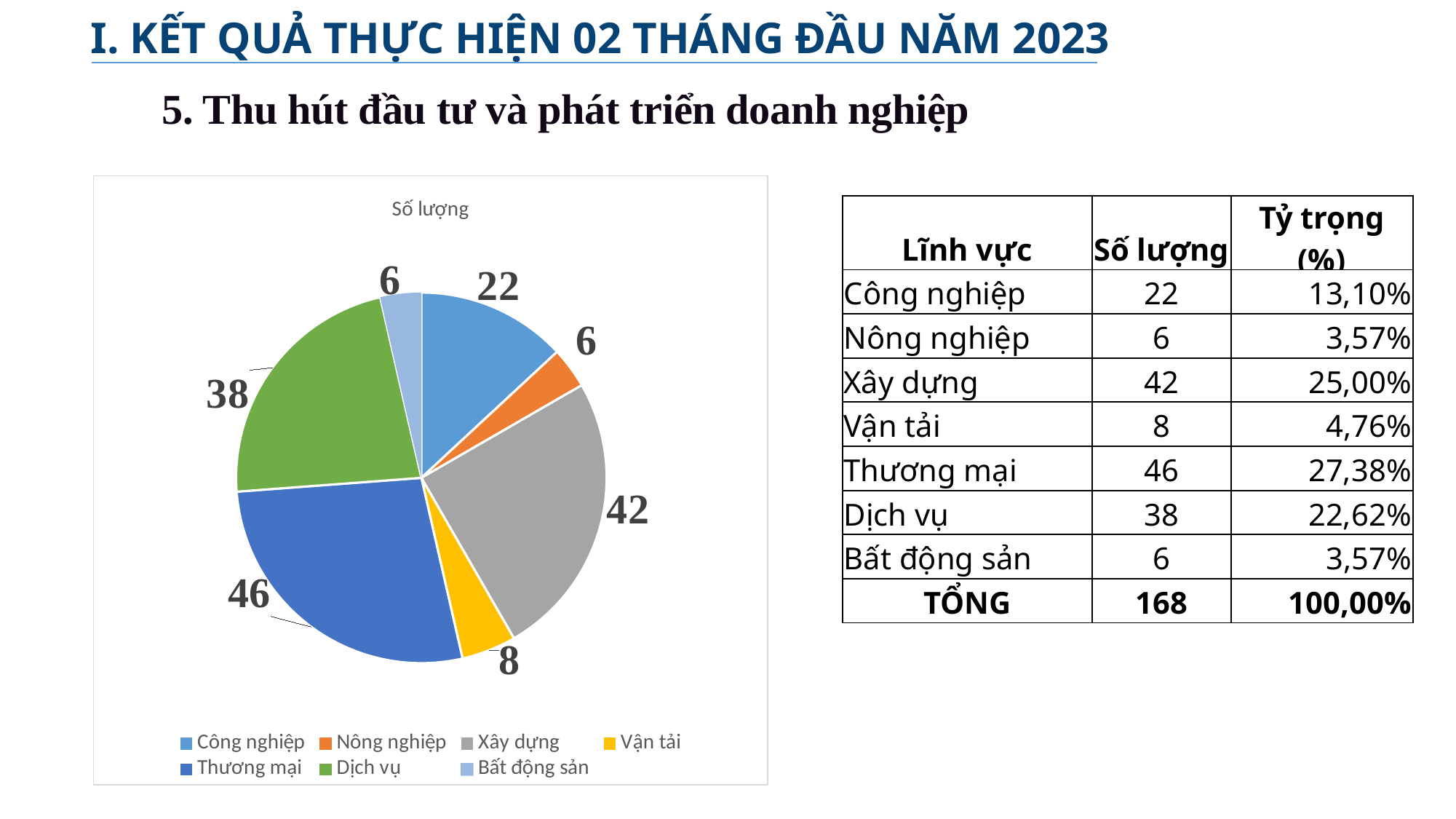
What share of the pie does Xây dựng represent? 25,00% Which category has the largest slice in the pie chart? Thương mại What is the value for Vận tải in the pie chart? 8 What is the value for Thương mại in the pie chart? 46 What is the difference between the values for Xây dựng and Công nghiệp in the pie chart? 20 What is the difference between the values for Thương mại and Dịch vụ in the pie chart? 8 How many categories does the pie chart show? 7 Which category has the smallest value in the pie chart, Vận tải or Công nghiệp? Vận tải What is the value for Dịch vụ in the pie chart? 38 What is the value for Xây dựng in the pie chart? 42 What is the title of the pie chart? Số lượng What kind of chart is shown on the slide? pie chart